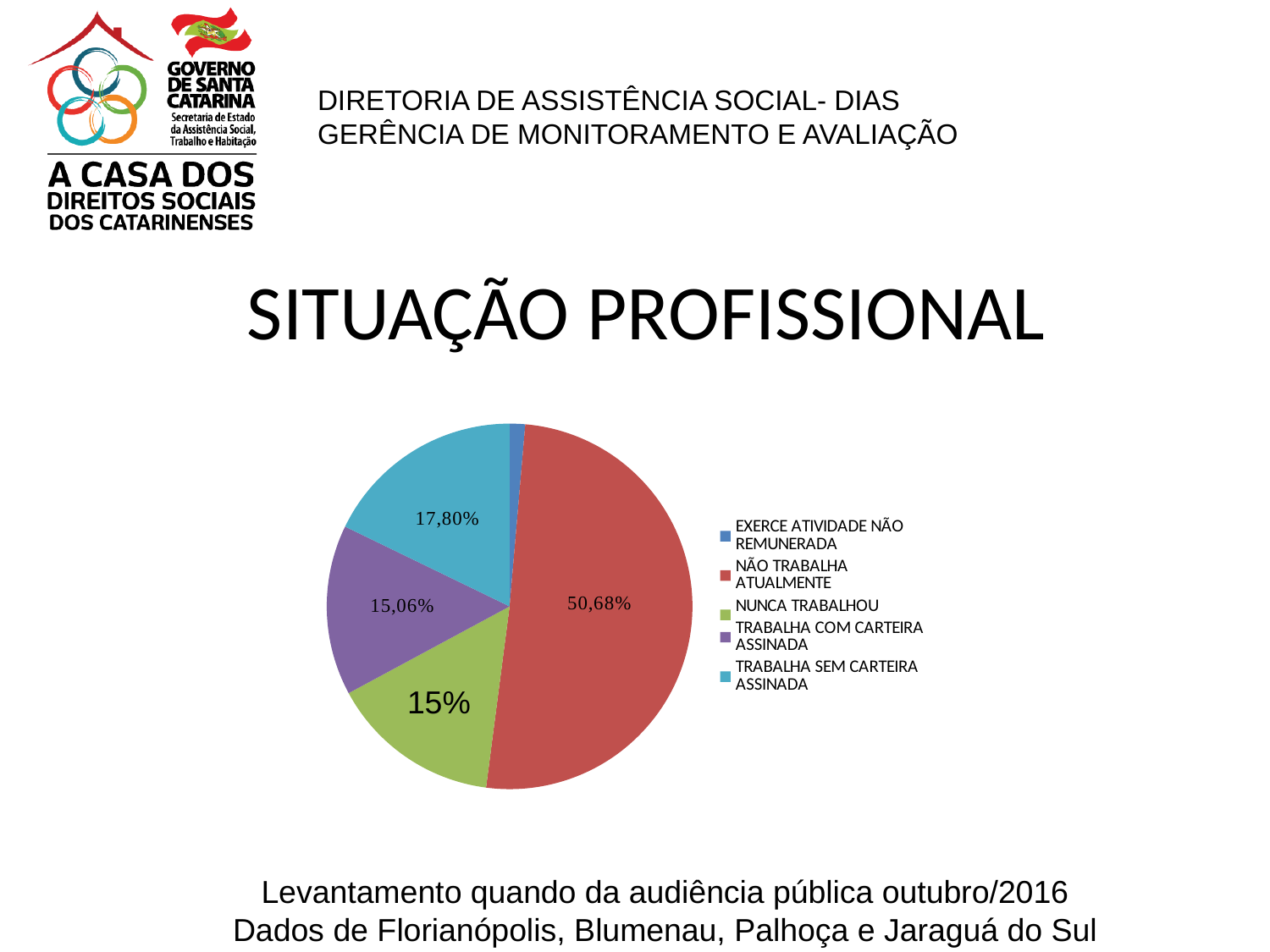
Which category has the largest slice of the pie? NÃO TRABALHA ATUALMENTE What share of the pie is labelled for TRABALHA SEM CARTEIRA ASSINADA? 17,80% What share of the pie is labelled for NUNCA TRABALHOU? 15% What share of the pie is labelled for NÃO TRABALHA ATUALMENTE? 50,68% What kind of chart is shown on the slide? Pie chart Which category has the smallest slice of the pie? EXERCE ATIVIDADE NÃO REMUNERADA What share of the pie is labelled for TRABALHA COM CARTEIRA ASSINADA? 15,06% What colour is the slice for NÃO TRABALHA ATUALMENTE? Red How many categories does the legend list? 5 Which slice is larger: NÃO TRABALHA ATUALMENTE or TRABALHA SEM CARTEIRA ASSINADA? NÃO TRABALHA ATUALMENTE What is the difference in percentage points between NÃO TRABALHA ATUALMENTE and TRABALHA SEM CARTEIRA ASSINADA? 32,88% What is the title of the chart on the slide? SITUAÇÃO PROFISSIONAL